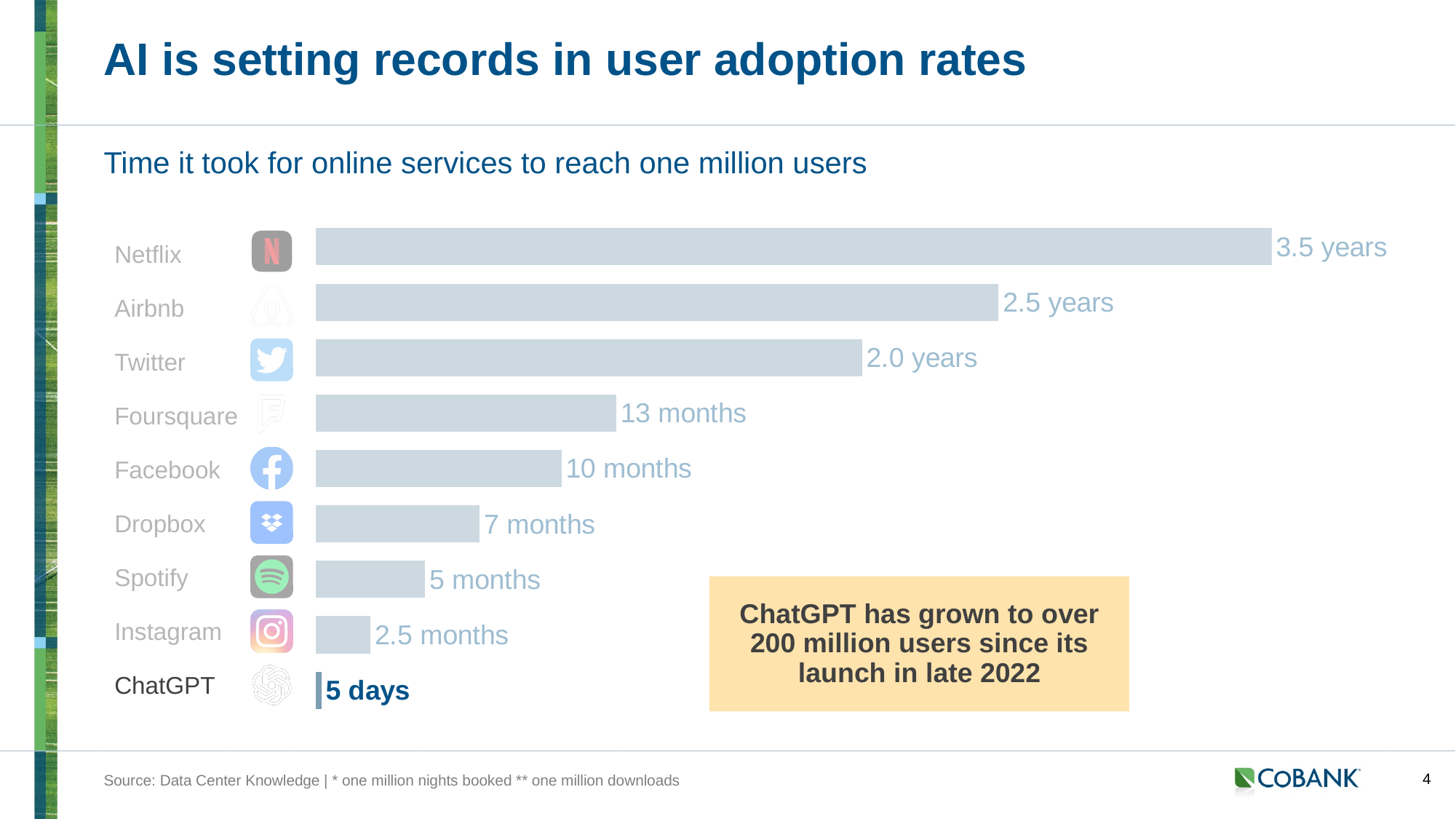
What value is shown for Instagram? 2.5 months How long did it take Netflix to reach one million users according to the chart? 3.5 years How long did Foursquare take to reach one million users? 13 months Which service took the longest to reach one million users? Netflix What type of chart is used on this slide? Bar chart What is the difference between Dropbox's and Spotify's times? 2 months Which service took the shortest time to reach one million users? ChatGPT Which took longer to reach one million users, Airbnb or Twitter? Airbnb How many months longer did Foursquare take than Facebook? 3 months How many online services are shown in the chart? 9 What is the value shown for ChatGPT in the chart? 5 days What is the title of the chart? Time it took for online services to reach one million users